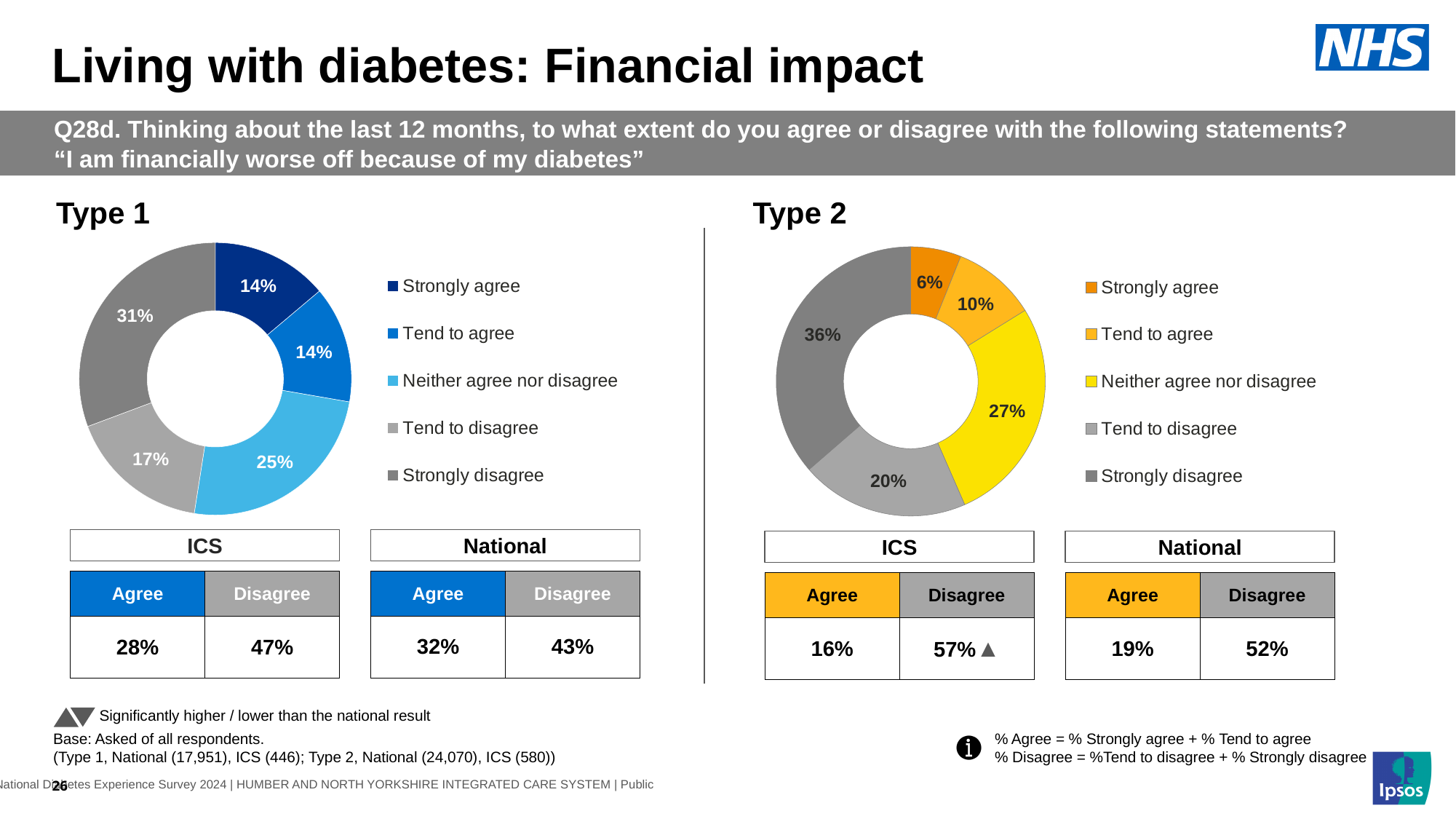
In the Type 2 chart, what is the ICS Disagree percentage? 57% In the Type 1 chart, which is larger: the Neither agree nor disagree share or the Tend to disagree share? Neither agree nor disagree How many response categories does the Type 2 chart's legend list? 5 In the Type 1 chart, what is the National Agree percentage? 32% In the Type 2 chart, what is the difference between the Strongly disagree share and the Tend to disagree share? 16% In the Type 1 chart, what is the combined share of Strongly agree and Tend to agree? 28% In the Type 2 chart, which response category has the smallest share? Strongly agree In the Type 2 chart, what colour represents Strongly agree? Orange In the Type 1 chart, what percentage of respondents strongly agree? 14% In the Type 1 chart, which response category has the largest share? Strongly disagree What kind of chart is used to show the Type 1 results? Doughnut chart In the Type 2 chart, what percentage of respondents neither agree nor disagree? 27%